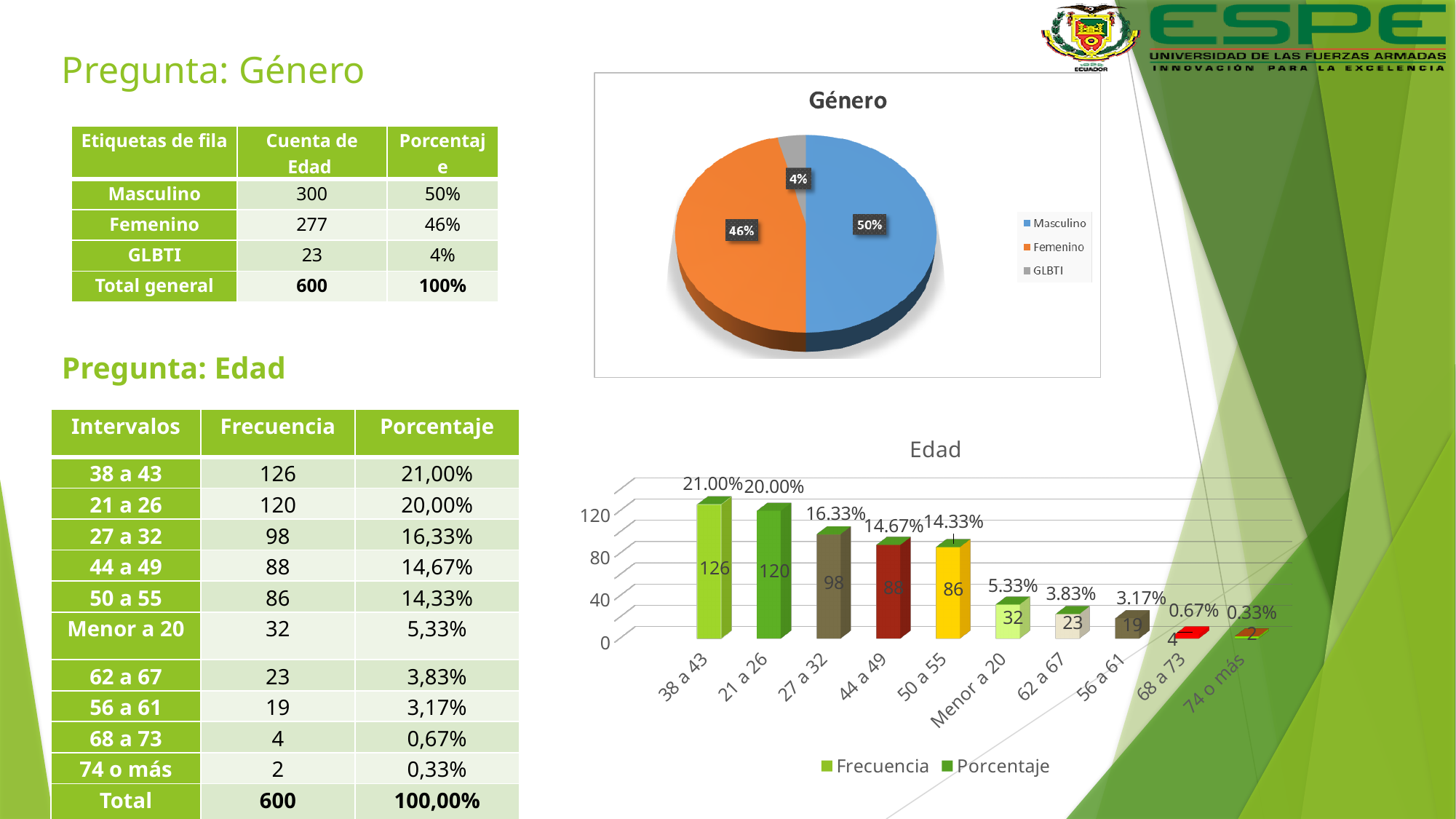
In the Edad chart, what is the Frecuencia value for 27 a 32? 98 In the Edad chart, which interval has the lowest frequency? 74 o más What kind of chart is the Edad chart? Bar chart How many entries does the legend of the Género pie chart list? 3 In the Edad chart, which interval has the highest frequency? 38 a 43 What kind of chart is the Género chart? Pie chart In the Género pie chart, what share does Masculino have? 50% In the Género pie chart, what share does GLBTI have? 4% In the Género pie chart, which category has the smallest slice? GLBTI In the Edad chart, what is the difference in frequency between 38 a 43 and 21 a 26? 6 How many intervals are shown on the x axis of the Edad chart? 10 In the Edad chart, what percentage label is shown for Menor a 20? 5.33%